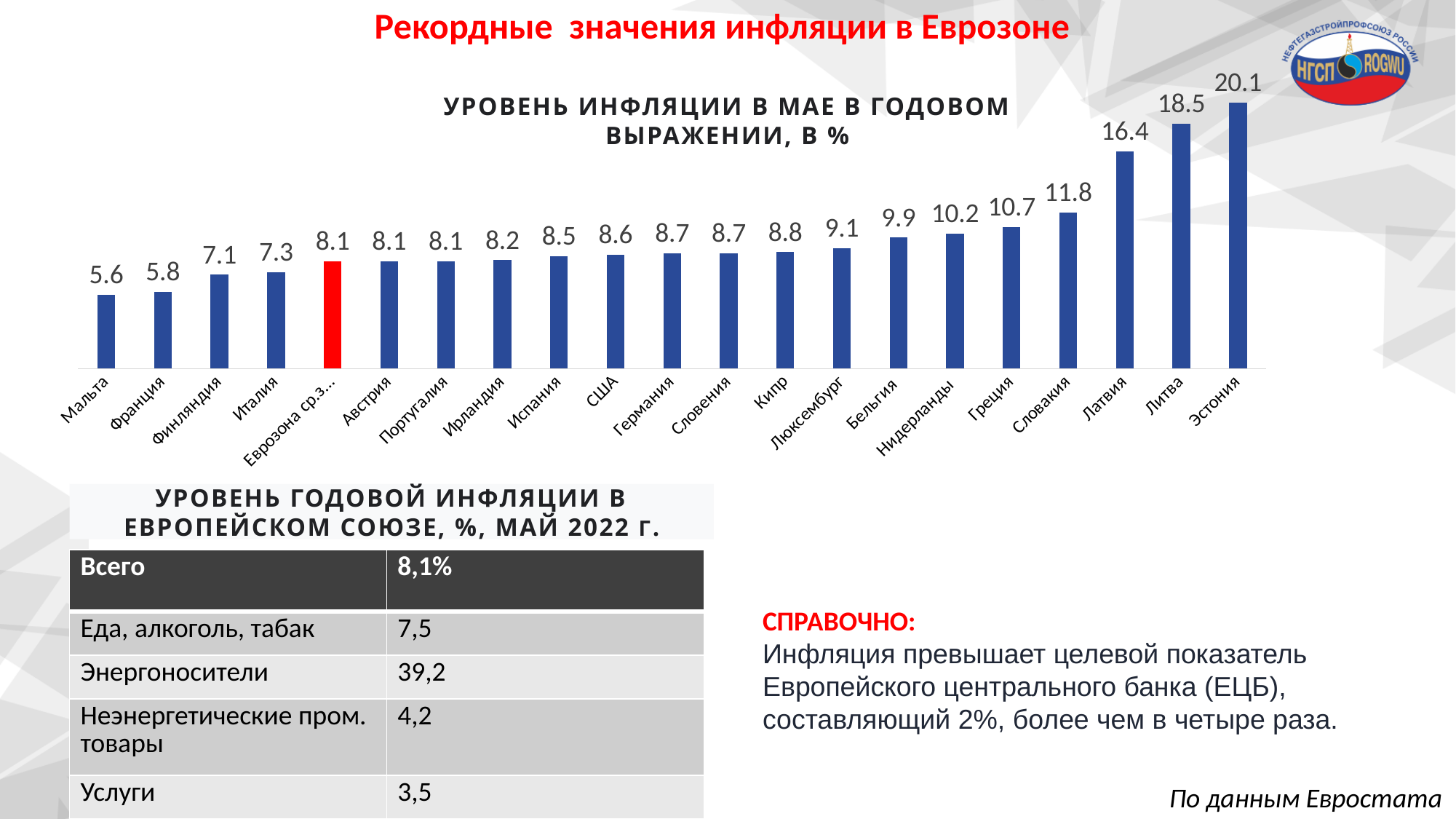
Which has a higher value, Греция or Нидерланды? Греция Which country has the highest inflation value in the chart? Эстония What type of chart is shown on the slide? Bar chart How many bars are plotted in the chart? 21 What is the difference between the values for Литва and Латвия? 2.1 Which country has the lowest inflation value in the chart? Мальта Which bar in the chart is coloured red? Еврозона ср.з... What is the inflation value shown for Мальта? 5.6 Do the values rise or fall from left to right along the x axis? Rise What is the difference between the values for Эстония and Мальта? 14.5 What is the value shown for Германия? 8.7 What is the inflation value shown for Эстония? 20.1